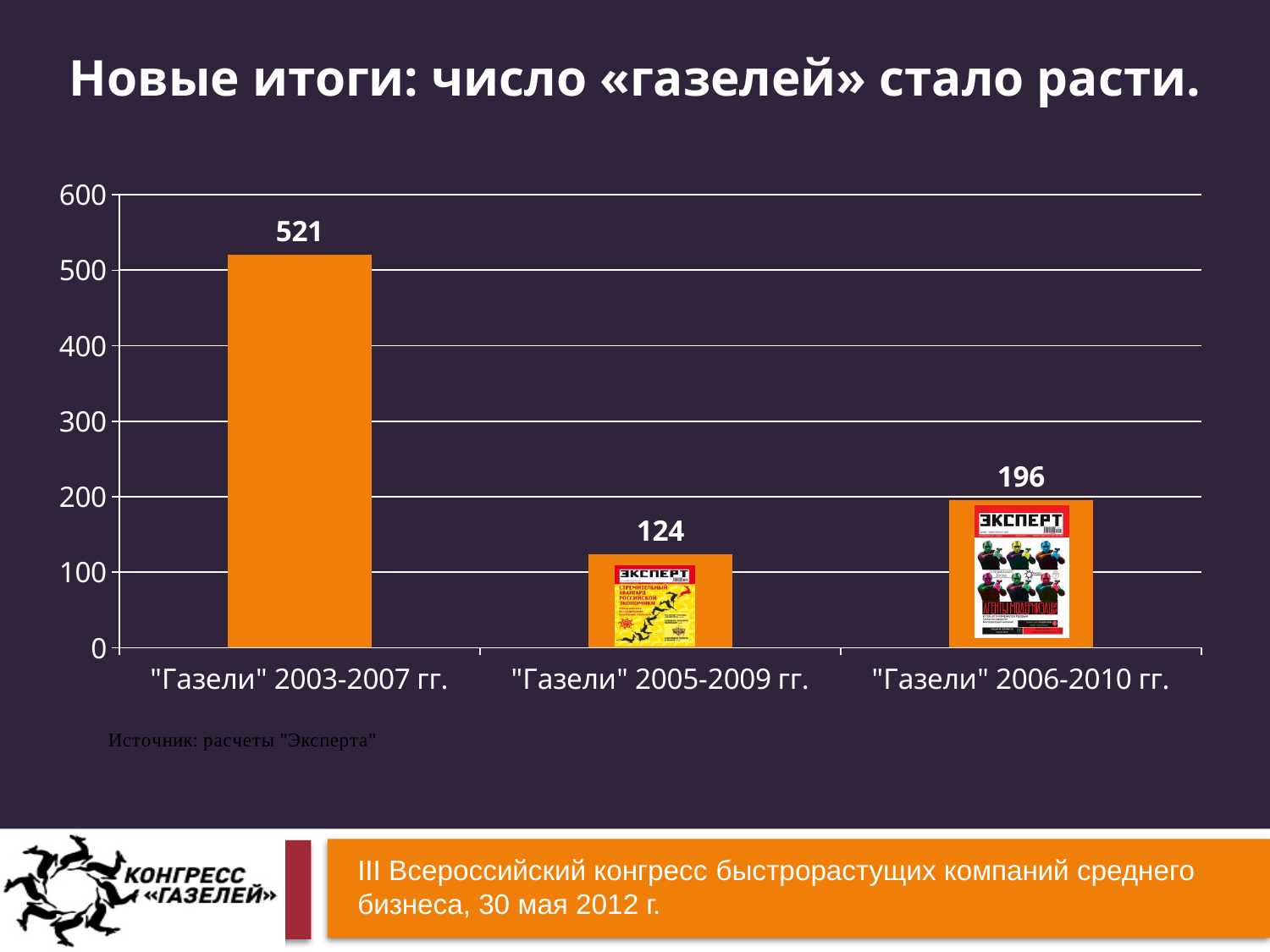
What kind of chart is shown on the slide? bar chart What is the value for "Газели" 2003-2007 гг.? 521 What is the difference between the values for "Газели" 2006-2010 гг. and "Газели" 2005-2009 гг.? 72 Which is larger: the value for "Газели" 2005-2009 гг. or "Газели" 2006-2010 гг.? "Газели" 2006-2010 гг. Is the value for "Газели" 2003-2007 гг. greater or less than 500? greater What is the value for "Газели" 2006-2010 гг.? 196 What is the difference between the values for "Газели" 2003-2007 гг. and "Газели" 2006-2010 гг.? 325 Which category has the highest value? "Газели" 2003-2007 гг. Which category has the lowest value? "Газели" 2005-2009 гг. What is the value for "Газели" 2005-2009 гг.? 124 How many categories are shown on the chart? 3 What is the source cited below the chart? расчеты "Эксперта"